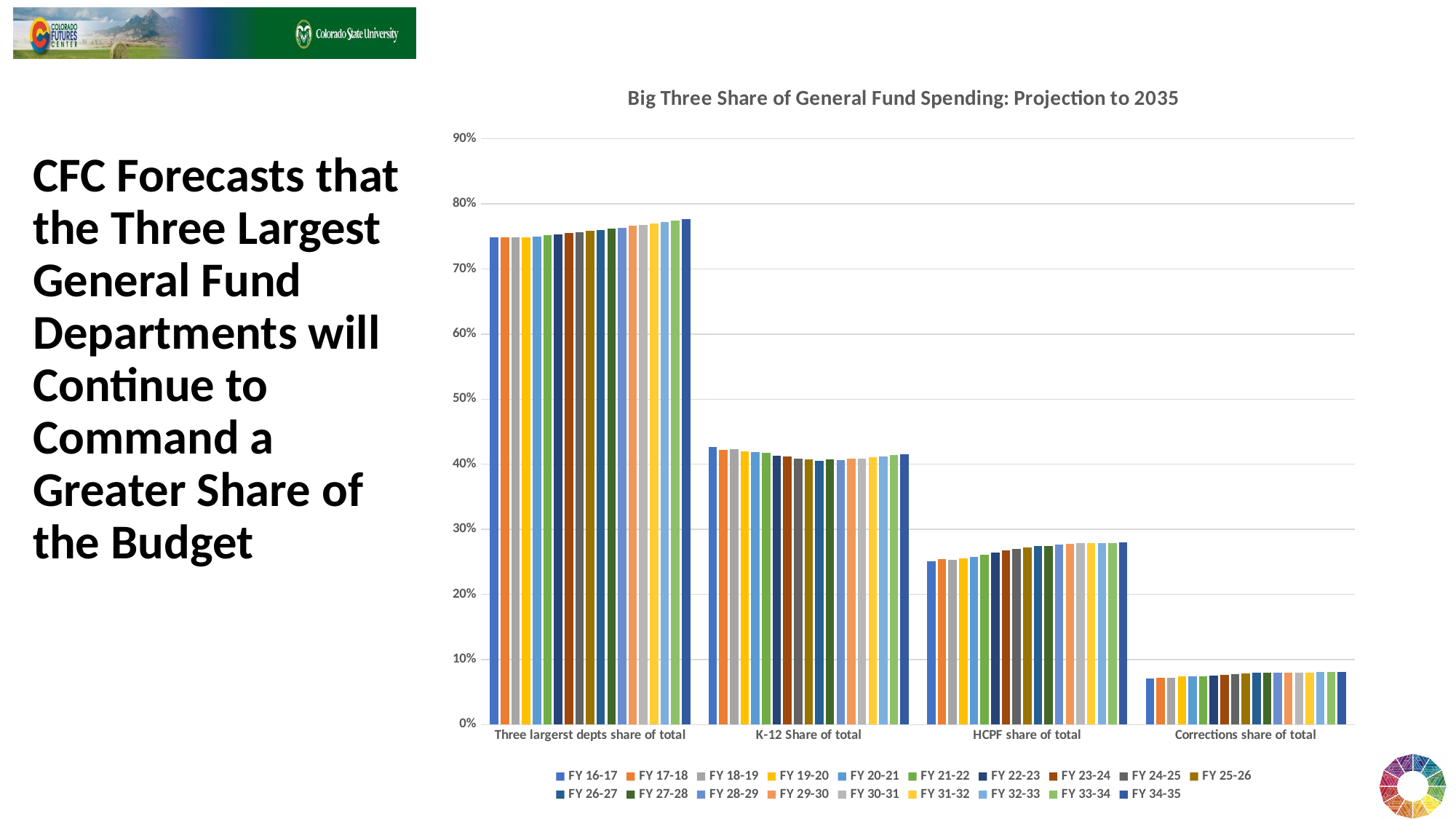
Is the value for Corrections share of total in FY 16-17 greater or less than 10%? less Which is larger in FY 16-17: K-12 Share of total or HCPF share of total? K-12 Share of total Which category has the lowest values in the chart? Corrections share of total How many fiscal-year series does the legend list? 19 Which category has the highest values in the chart? Three largerst depts share of total Is the value for Three largerst depts share of total in FY 34-35 greater or less than 70%? greater What kind of chart is shown on the slide? bar chart Is the value for HCPF share of total in FY 34-35 greater or less than 30%? less Do the HCPF share of total values rise or fall from FY 16-17 to FY 34-35? rise What is the title of the chart? Big Three Share of General Fund Spending: Projection to 2035 How many categories are shown along the x axis of the chart? 4